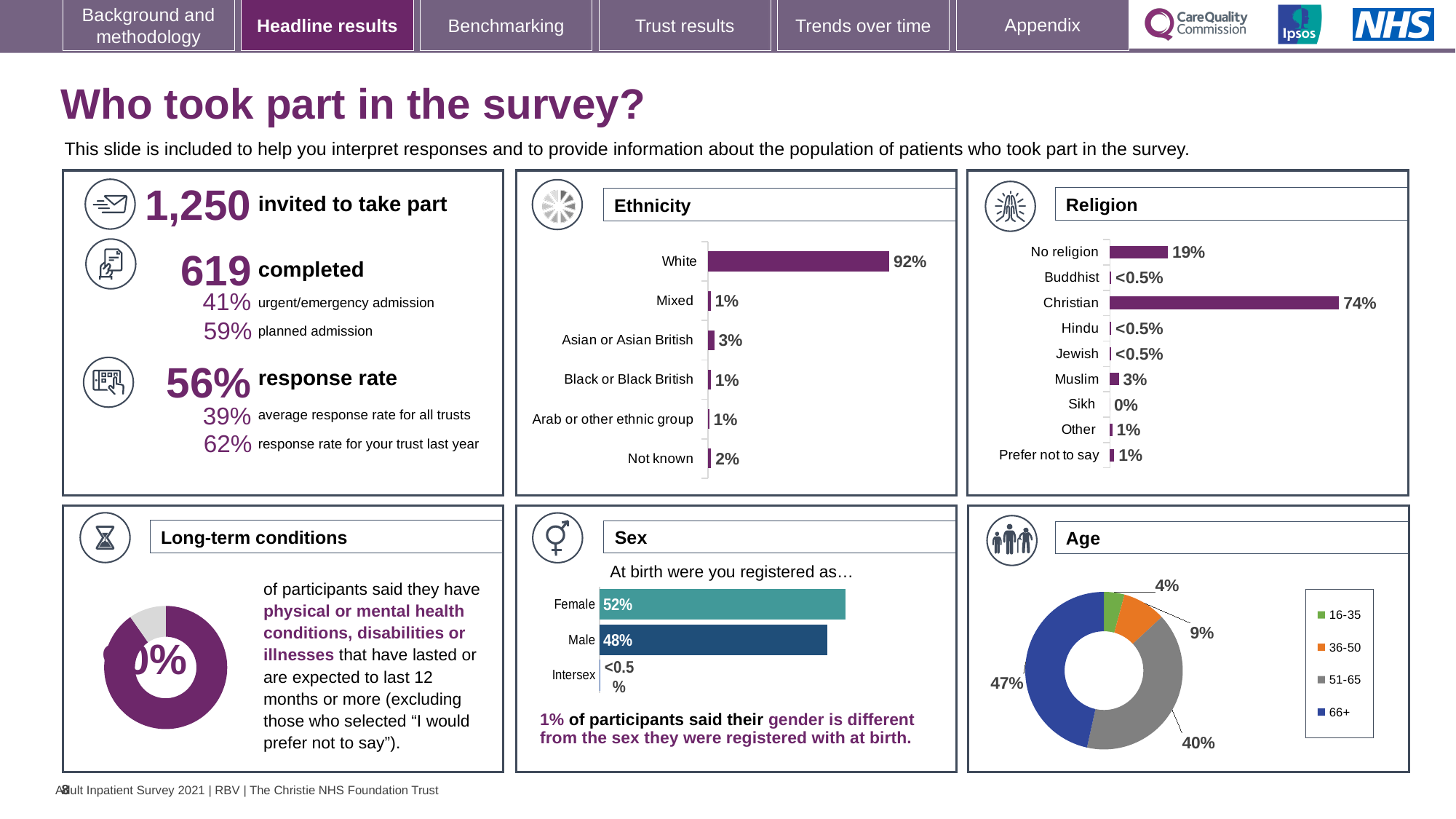
In the Ethnicity chart, which ethnic group has the highest percentage? White In the Religion chart, what percentage of participants had no religion? 19% How many age groups does the legend of the Age chart list? 4 In the Sex chart, which is larger, the Female or the Male percentage? Female How many ethnic group categories are shown in the Ethnicity chart? 6 How many religion categories are shown in the Religion chart? 9 In the Sex chart, what percentage of participants were registered as Female at birth? 52% In the Religion chart, what percentage of participants were Christian? 74% In the Religion chart, what is the difference between the Christian and No religion percentages? 55% In the Ethnicity chart, what percentage of participants were White? 92% What kind of chart is the Ethnicity chart? Bar chart In the Age chart, what percentage of participants were aged 51-65? 40%